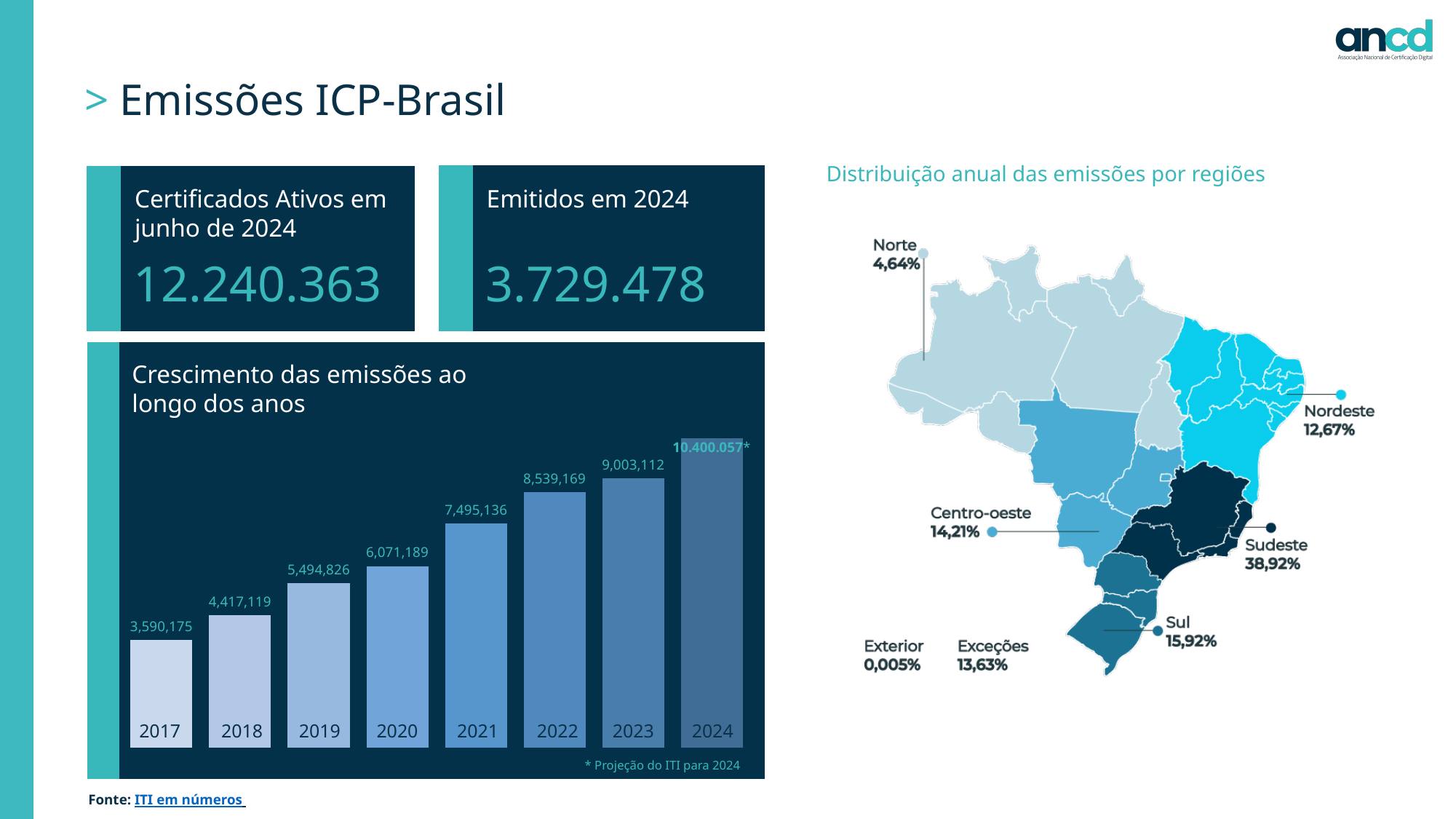
In the 'Crescimento das emissões ao longo dos anos' chart, what is the value for 2022? 8,539,169 In the 'Crescimento das emissões ao longo dos anos' chart, what is the value for 2019? 5,494,826 In the 'Distribuição anual das emissões por regiões' map, which region has the highest share? Sudeste In the 'Crescimento das emissões ao longo dos anos' chart, which year has the lowest value? 2017 What kind of chart is 'Crescimento das emissões ao longo dos anos'? Bar chart In the 'Crescimento das emissões ao longo dos anos' chart, what is the projected value for 2024? 10.400.057 In the 'Crescimento das emissões ao longo dos anos' chart, which is larger, the value for 2020 or the value for 2021? 2021 In the 'Crescimento das emissões ao longo dos anos' chart, what is the difference between the 2023 and 2022 values? 463,943 In the 'Crescimento das emissões ao longo dos anos' chart, what is the difference between the 2018 and 2017 values? 826,944 In the 'Crescimento das emissões ao longo dos anos' chart, do the values rise or fall from 2017 to 2024? Rise How many years are shown in the 'Crescimento das emissões ao longo dos anos' chart? 8 In the 'Crescimento das emissões ao longo dos anos' chart, which year has the highest value? 2024